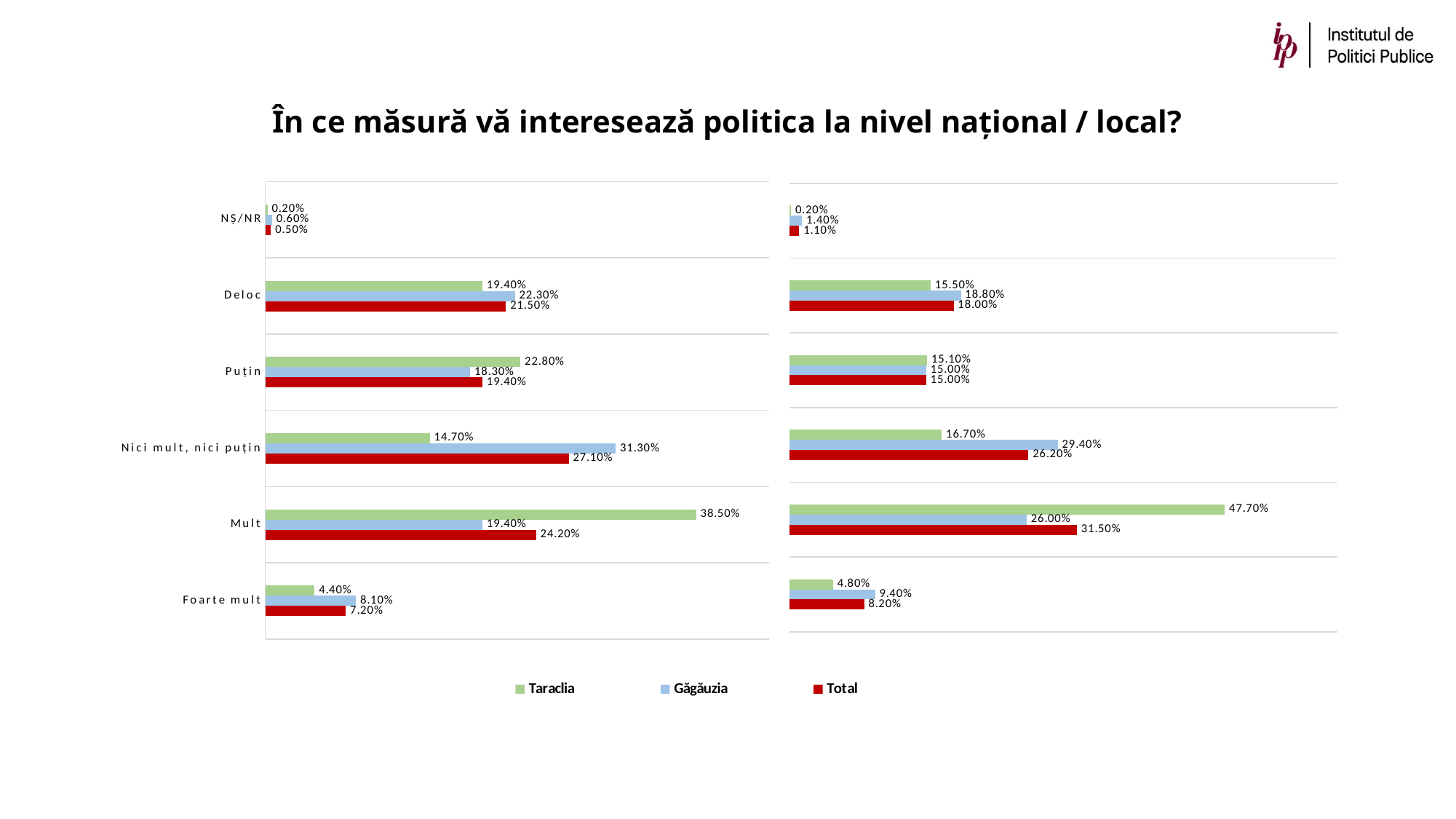
In the left chart, what is the difference between the Taraclia and Găgăuzia values for Mult? 19.10% In the right chart, what is the difference between the Găgăuzia and Taraclia values for Nici mult, nici puțin? 12.70% How many series does the legend list? 3 In the left chart, which category has the highest value for Găgăuzia? Nici mult, nici puțin How many categories are shown on the vertical axis of the left chart? 6 In the right chart, which category has the lowest Total value? NȘ/NR In the left chart, what is the value for Taraclia in the Mult category? 38.50% In the right chart, what is the Total value for Nici mult, nici puțin? 26.20% In the left chart, which is larger for Deloc: the Taraclia value or the Găgăuzia value? Găgăuzia What type of chart is the right chart? Bar chart In the right chart, what is the value for Găgăuzia in the Foarte mult category? 9.40% In the right chart, which is larger for Mult: the Total value or the Găgăuzia value? Total